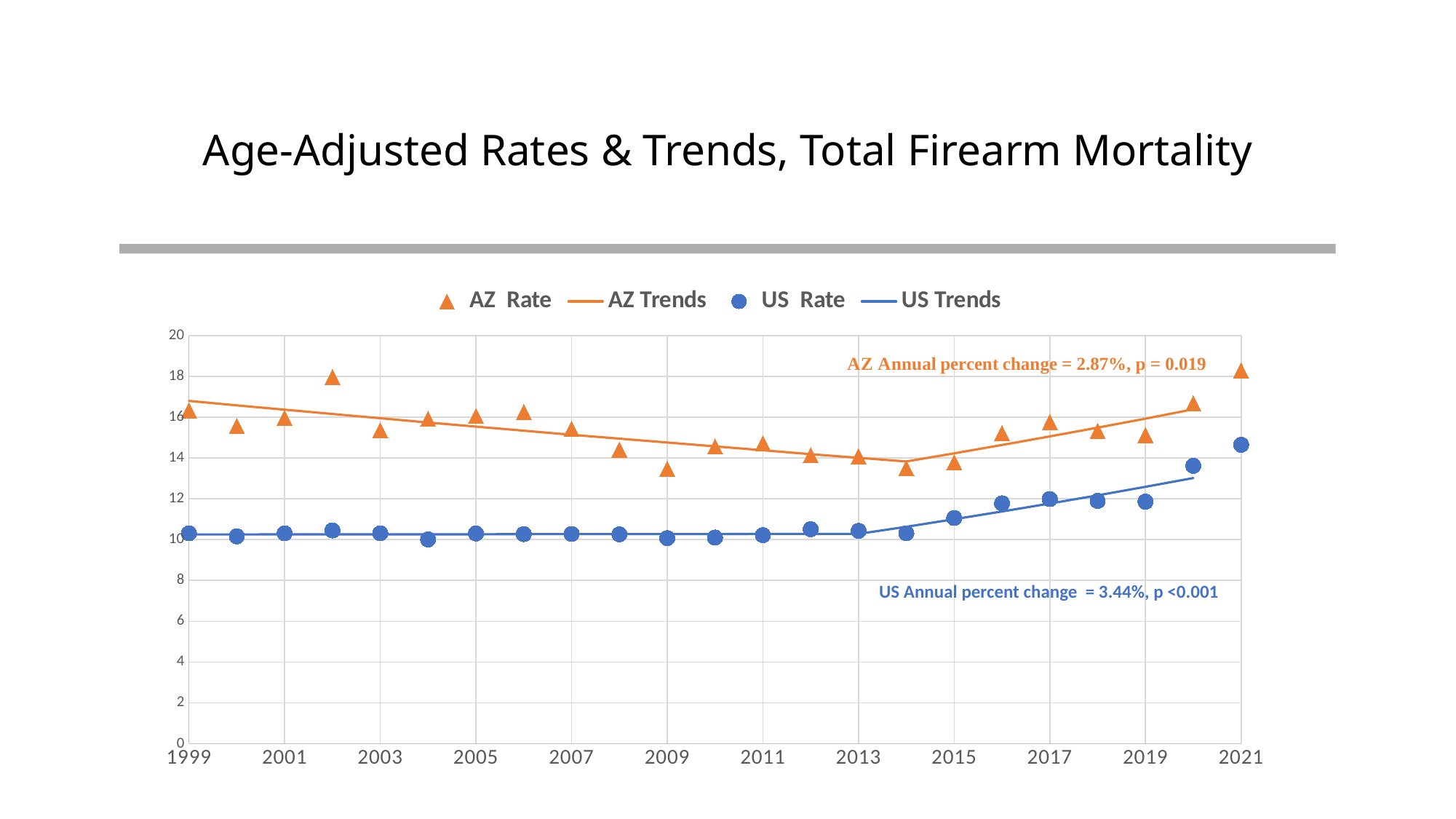
Is the AZ Rate for 2021 greater or less than 16? greater Does the US Trends line rise or fall between 2013 and 2020? rise Is the US Rate for 2021 greater or less than 12? greater Is the AZ Rate for 2002 greater or less than 16? greater In which year is the US Rate highest? 2021 How many series does the legend list? 4 What is the AZ annual percent change stated on the chart? 2.87% What is the title of the chart on the slide? Age-Adjusted Rates & Trends, Total Firearm Mortality What is the US annual percent change stated on the chart? 3.44% Which is larger in 2013, the AZ Rate or the US Rate? AZ Rate